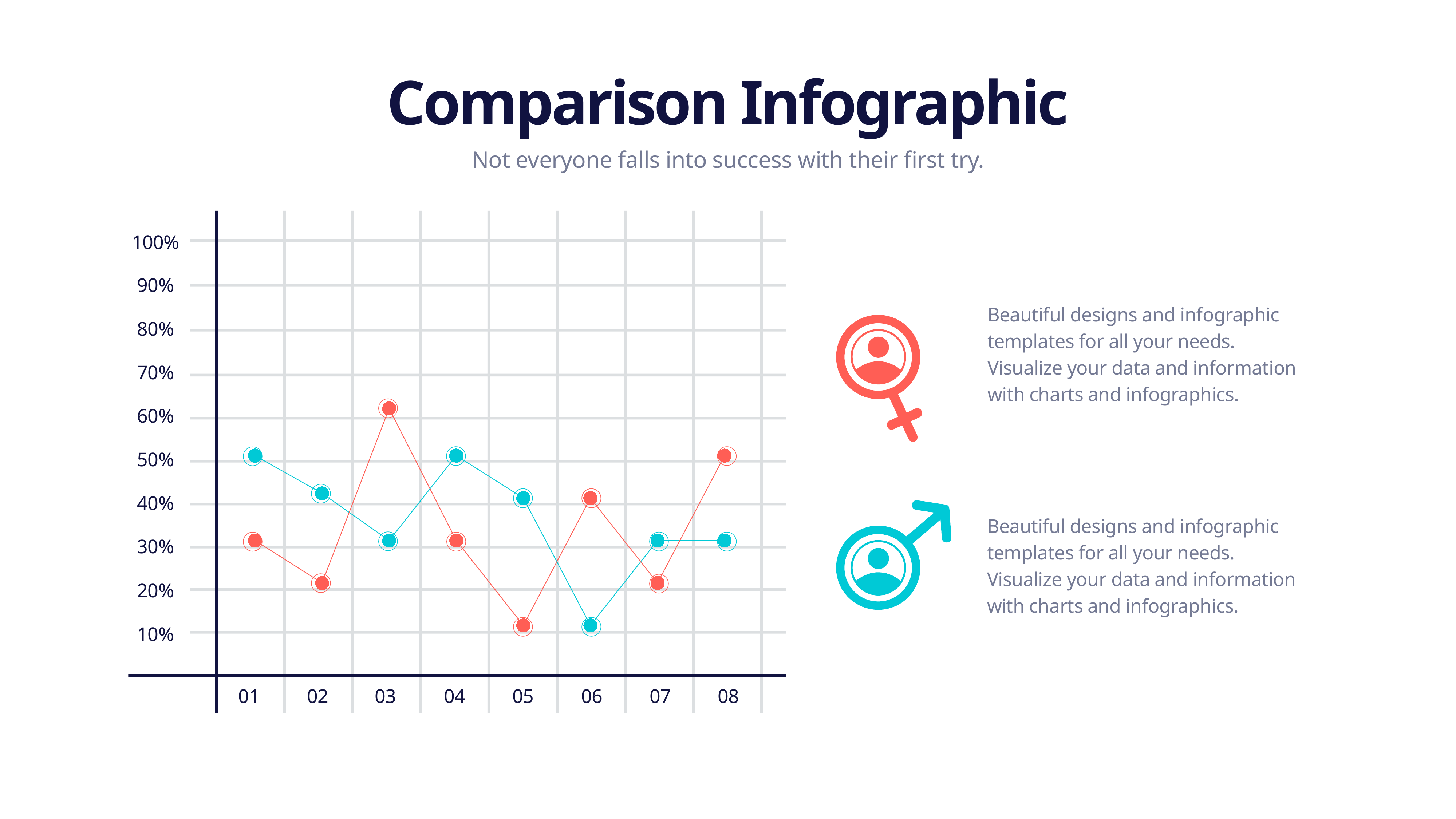
What kind of chart is shown on the slide? line chart How many lines are plotted on the chart? 2 Does the teal line rise or fall from 04 to 06? fall Is the value of the teal line at 06 greater or less than 20%? less At point 01, which line has the higher value, the red line or the teal line? teal line Is the value of the red line at 03 greater or less than 50%? greater How many points along the x axis does the chart have? 8 At which x-axis point does the red line reach its lowest value? 05 What is the title of the slide containing the chart? Comparison Infographic At which x-axis point does the teal line reach its lowest value? 06 Is the value of the red line at 08 greater or less than 40%? greater At which x-axis point does the red line reach its highest value? 03